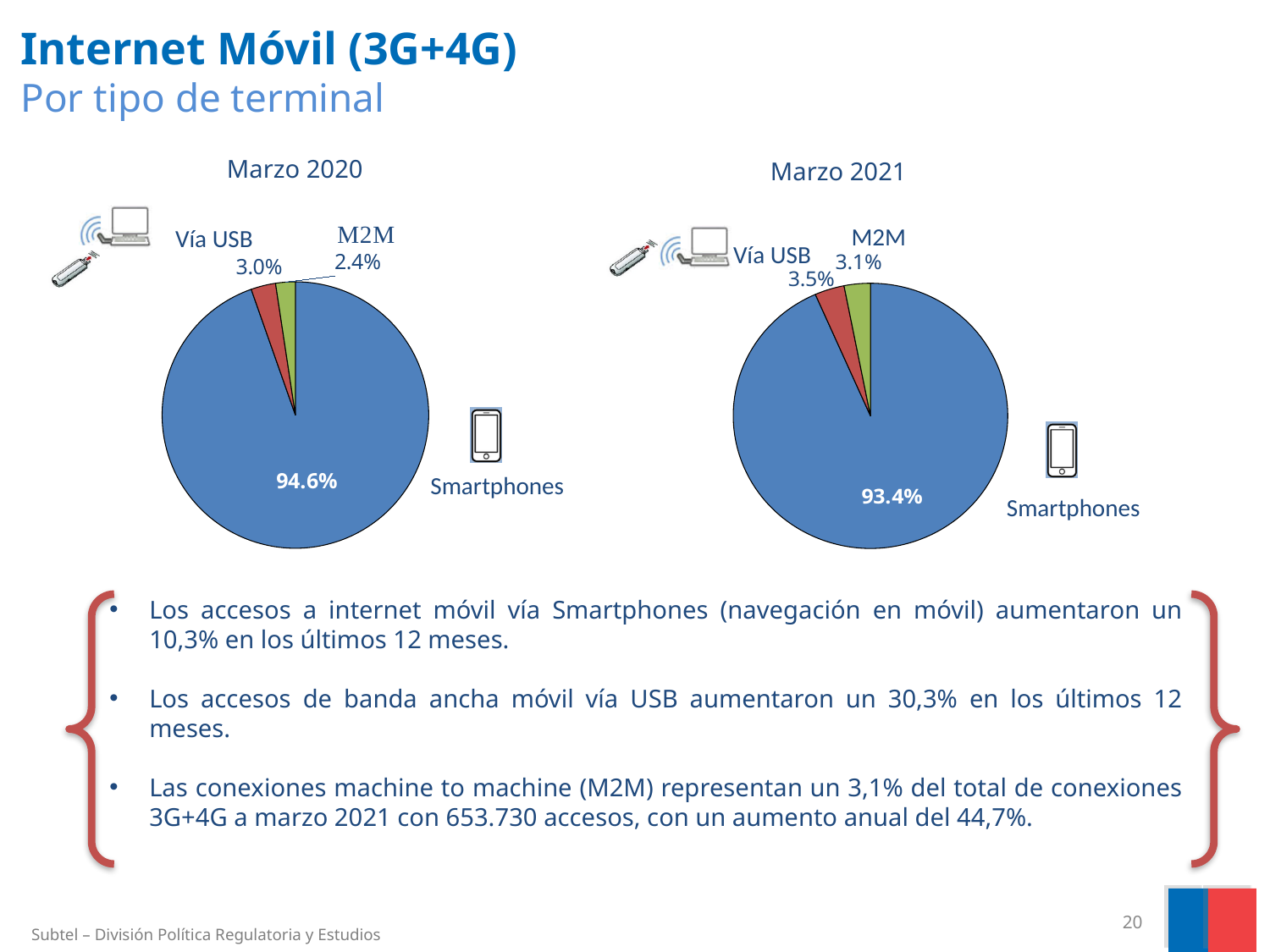
In the Marzo 2020 pie chart, what share do Smartphones have? 94.6% In the Marzo 2020 pie chart, what is the difference in percentage points between Vía USB and M2M? 0.6 In the Marzo 2020 pie chart, which category has the smallest slice? M2M What type of chart is used for Marzo 2020? Pie chart What is the difference in percentage points between the Smartphones share in the Marzo 2020 chart and in the Marzo 2021 chart? 1.2 In the Marzo 2021 pie chart, what is the share for M2M? 3.1% In the Marzo 2020 pie chart, what is the share for Vía USB? 3.0% In the Marzo 2021 pie chart, which is larger, Vía USB or M2M? Vía USB In the Marzo 2021 pie chart, which category has the largest slice? Smartphones How many slices does the Marzo 2021 pie chart have? 3 In the Marzo 2021 pie chart, what share do Smartphones have? 93.4% In the Marzo 2020 pie chart, what colour is the Smartphones slice? Blue